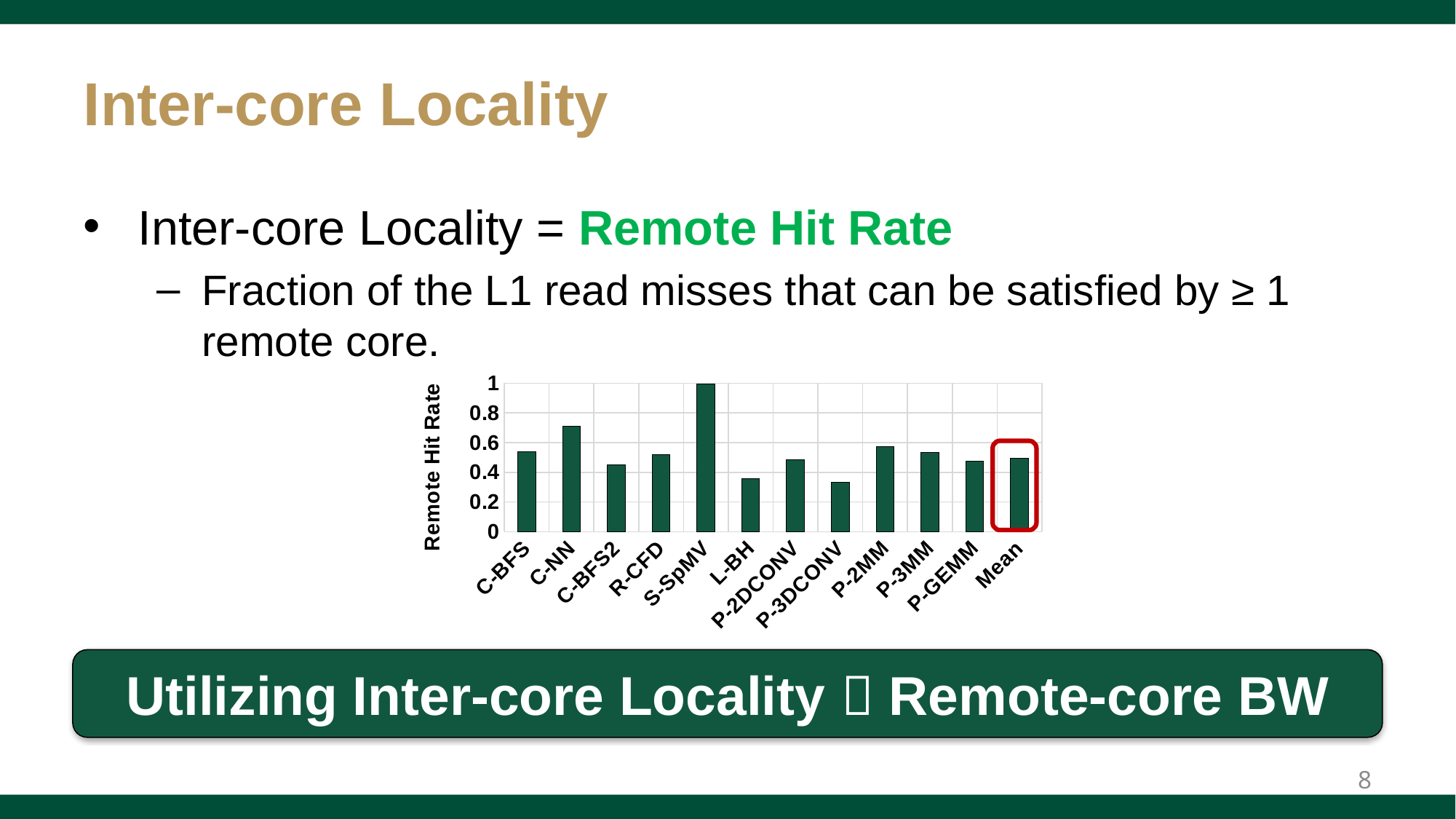
Is the Remote Hit Rate for C-BFS2 greater or less than 0.6? less Which has a larger Remote Hit Rate, C-NN or C-BFS2? C-NN What kind of chart is shown on the slide? bar chart How many categories are plotted on the x axis of the chart? 12 Is the Remote Hit Rate for C-NN greater or less than 0.6? greater Is the Remote Hit Rate for P-3DCONV greater or less than 0.4? less What is the label on the y axis of the chart? Remote Hit Rate Which has a larger Remote Hit Rate, S-SpMV or L-BH? S-SpMV Which bar in the chart is outlined with a red box? Mean Which category has the highest Remote Hit Rate? S-SpMV